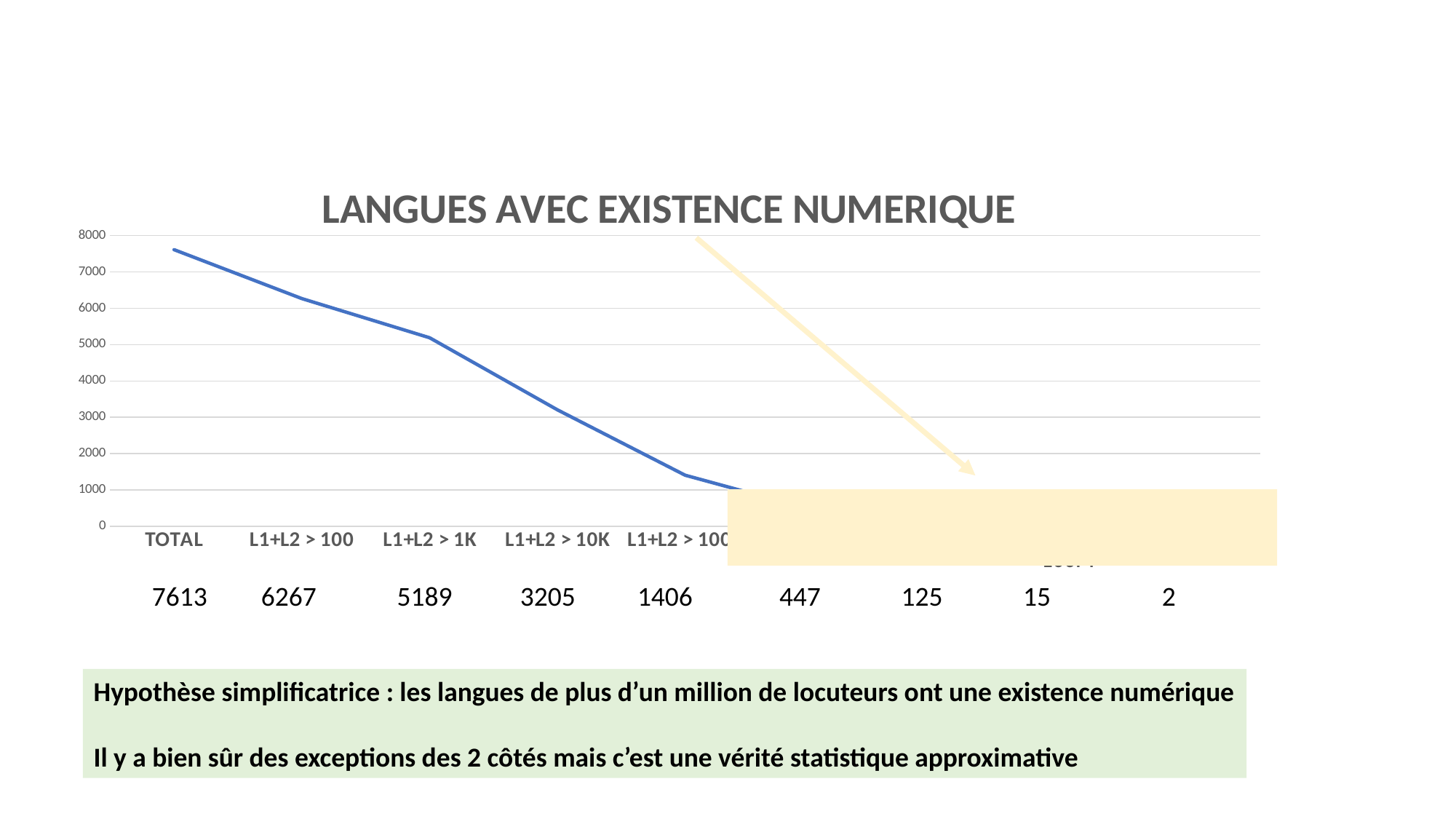
What is the difference between the values for TOTAL and L1+L2 > 100? 1346 What is the value for L1+L2 > 1K? 5189 What is the value for TOTAL? 7613 What is the value for L1+L2 > 10K? 3205 Which category has the highest value? TOTAL Do the values rise or fall from left to right along the x axis? fall What is the difference between the values for L1+L2 > 1K and L1+L2 > 10K? 1984 What is the highest value shown on the vertical axis? 8000 Which is larger, the value for L1+L2 > 1K or the value for L1+L2 > 10K? L1+L2 > 1K What is the title of the chart? LANGUES AVEC EXISTENCE NUMERIQUE What is the value for L1+L2 > 100? 6267 What kind of chart is shown on the slide? line chart